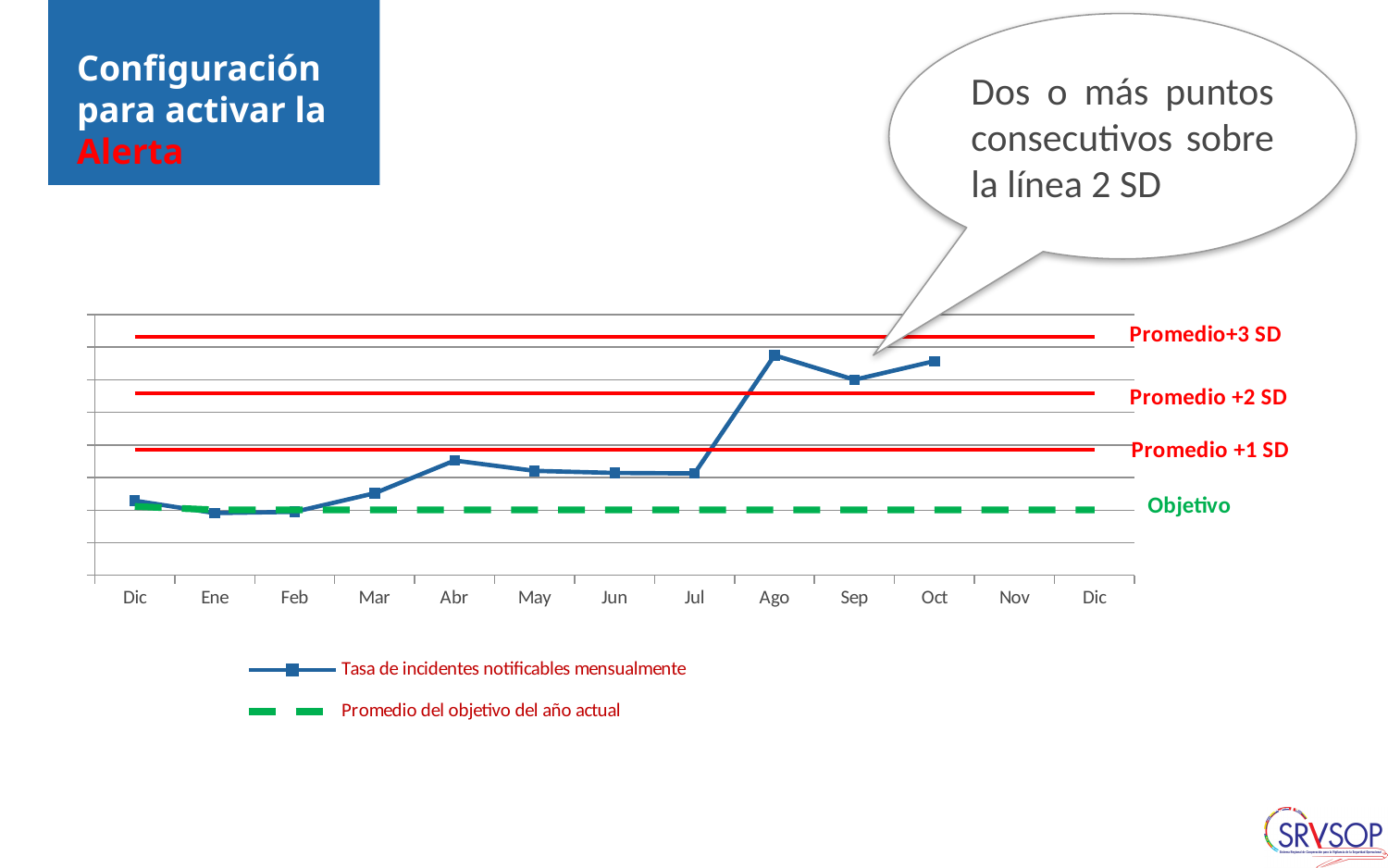
Which month has the higher incident rate, Jul or Ago? Ago Which months have points plotted above the 'Promedio +2 SD' line? Ago, Sep, Oct How many series does the chart legend list? 2 How many month categories are shown on the x axis? 13 What kind of chart is shown on the slide? Line chart How many months have a plotted point on the 'Tasa de incidentes notificables mensualmente' line? 11 In which month is the 'Tasa de incidentes notificables mensualmente' highest? Ago Does the incident rate rise or fall from Jul to Ago? Rise Does the incident rate rise or fall from Ago to Sep? Fall What does the green dashed line represent according to the legend? Promedio del objetivo del año actual Which month has the higher incident rate, Abr or Feb? Abr